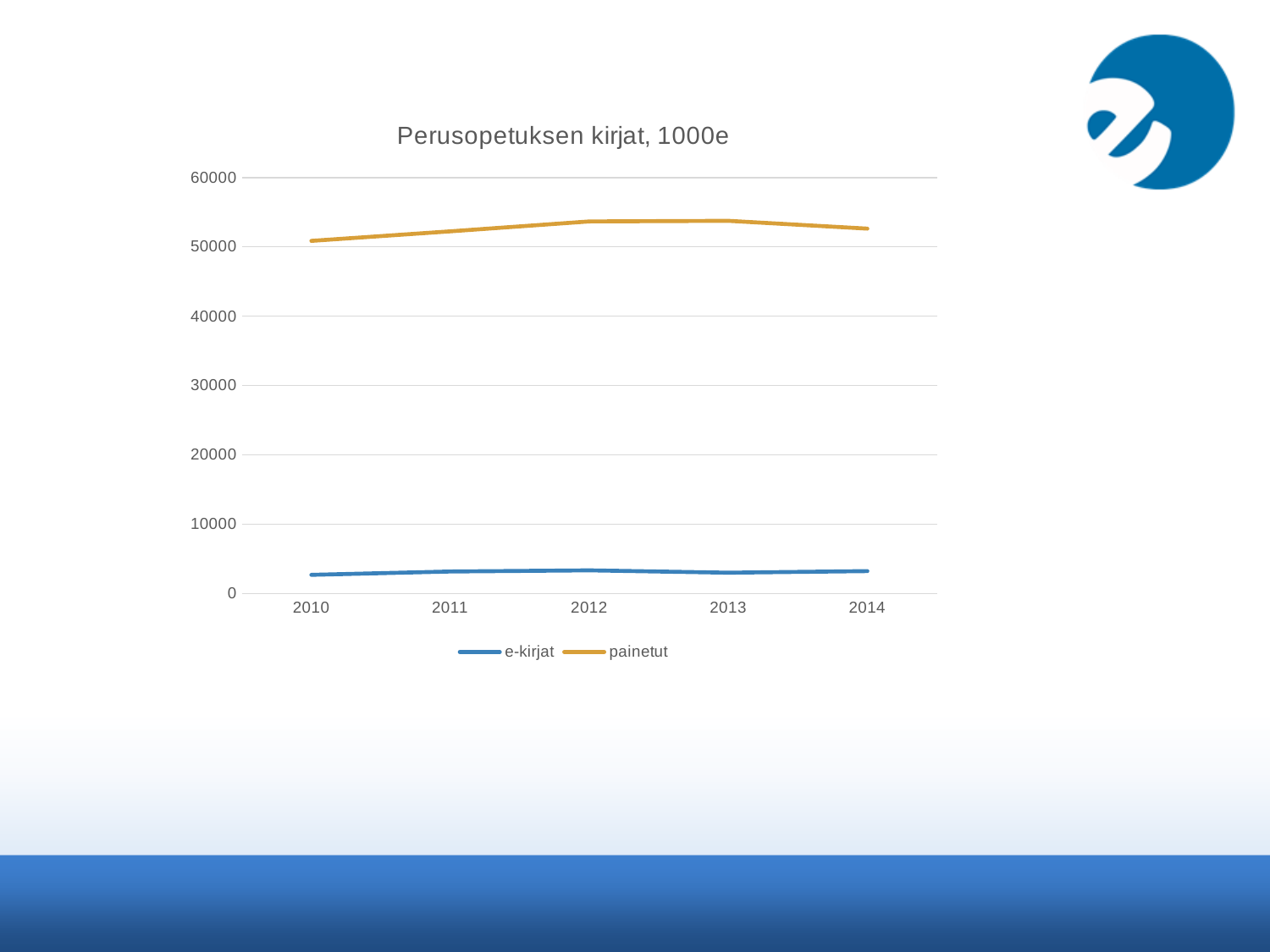
Which series has the larger value in 2014, e-kirjat or painetut? painetut How many series does the legend list? 2 What is the title of the chart? Perusopetuksen kirjat, 1000e What kind of chart is shown on the slide? line chart Does the painetut line rise or fall from 2013 to 2014? fall Does the painetut line rise or fall from 2010 to 2012? rise Which series are listed in the legend? e-kirjat and painetut In which year is the value for painetut lowest? 2010 Is the value for painetut in 2013 greater or less than 60000? less Is the value for e-kirjat in 2012 greater or less than 10000? less How many years are shown on the x axis? 5